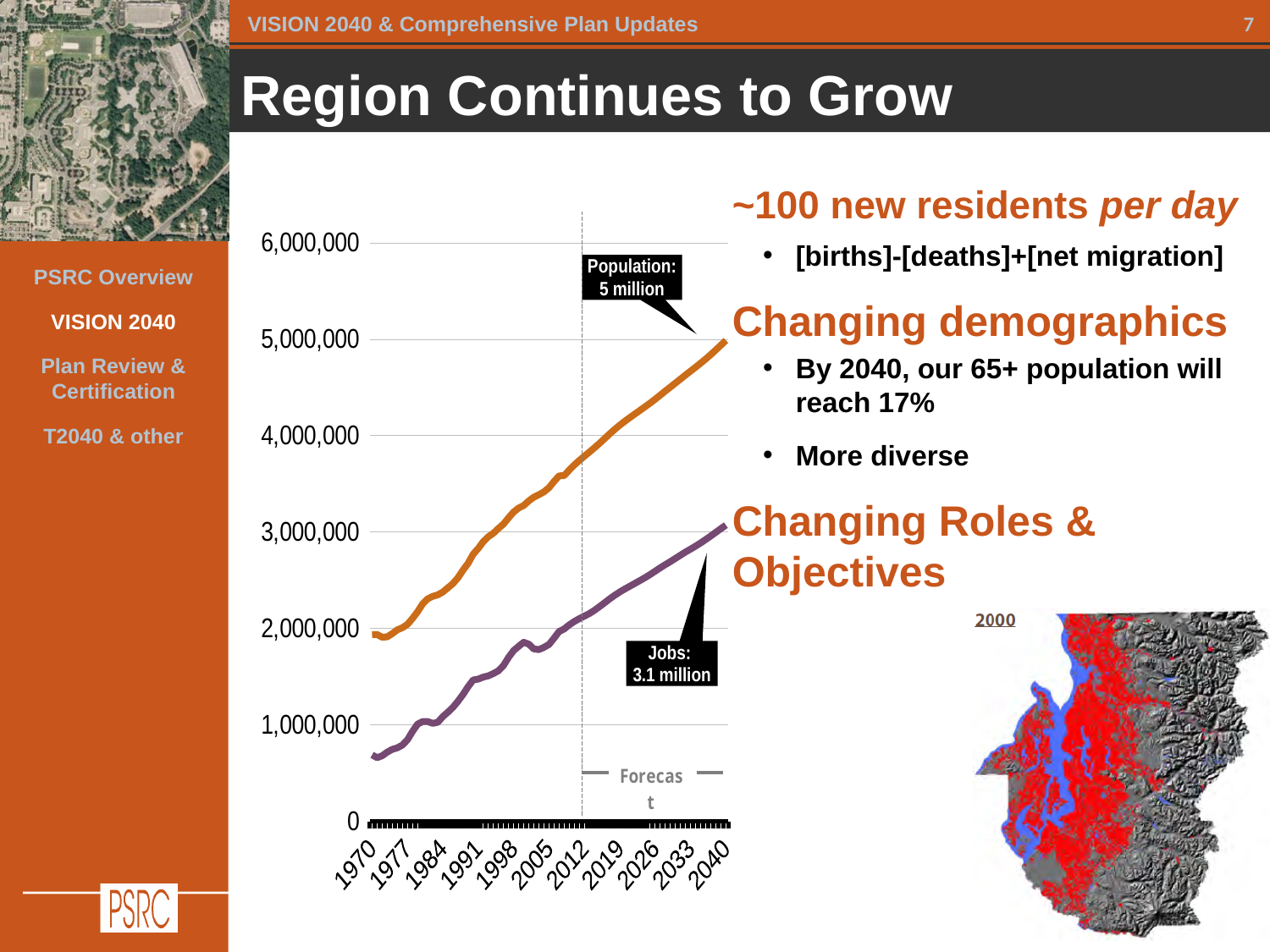
What label appears next to the dashed vertical line on the chart? Forecast Is the value of the population line in 2040 greater or less than 6,000,000? less What kind of chart is shown on the slide? line chart Does the population line rise or fall from 1970 to 2040? rise In 2040, which is larger on the chart: population or jobs? population Does the jobs line rise or fall from 1970 to 2040? rise According to the callout on the chart, what is the jobs forecast for 2040? 3.1 million Is the value of the population line in 2012 greater or less than 3,000,000? greater According to the callout on the chart, what is the population forecast for 2040? 5 million Is the value of the jobs line in 1970 greater or less than 1,000,000? less What colour is the population line on the chart? orange What is the first year shown on the x axis of the chart? 1970